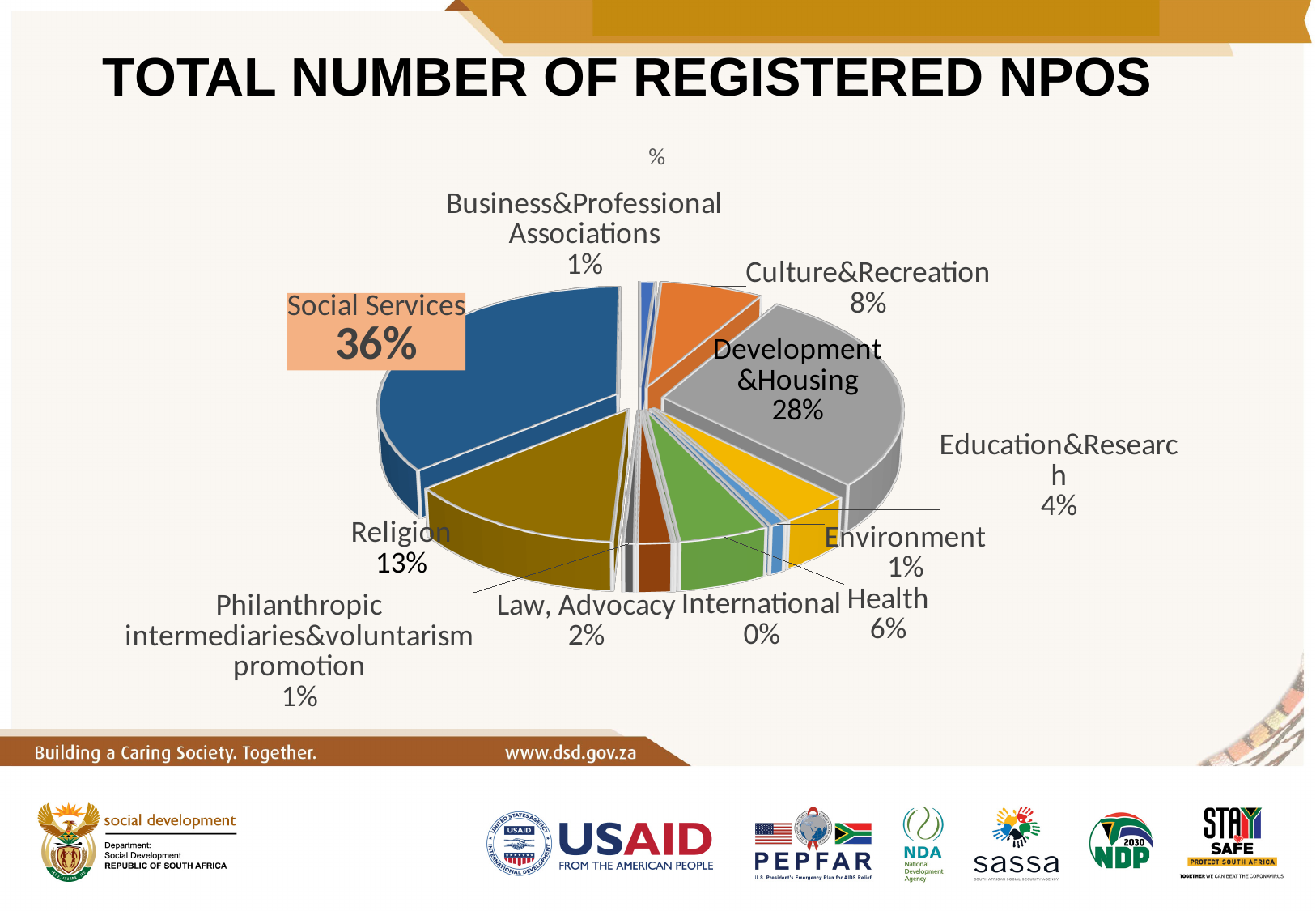
What kind of chart is shown on the slide? Pie chart What share of registered NPOs is Religion? 13% Which category has the largest share of registered NPOs? Social Services How many categories are shown in the pie chart? 11 What is the difference in percentage points between Social Services and Development&Housing? 8 Which category has the smallest share of registered NPOs? International What share of registered NPOs is Health? 6% Which has a larger share, Religion or Culture&Recreation? Religion What share of registered NPOs is Social Services? 36% What share of registered NPOs is Culture&Recreation? 8% What share of registered NPOs is Development&Housing? 28% What share of registered NPOs is Law, Advocacy? 2%